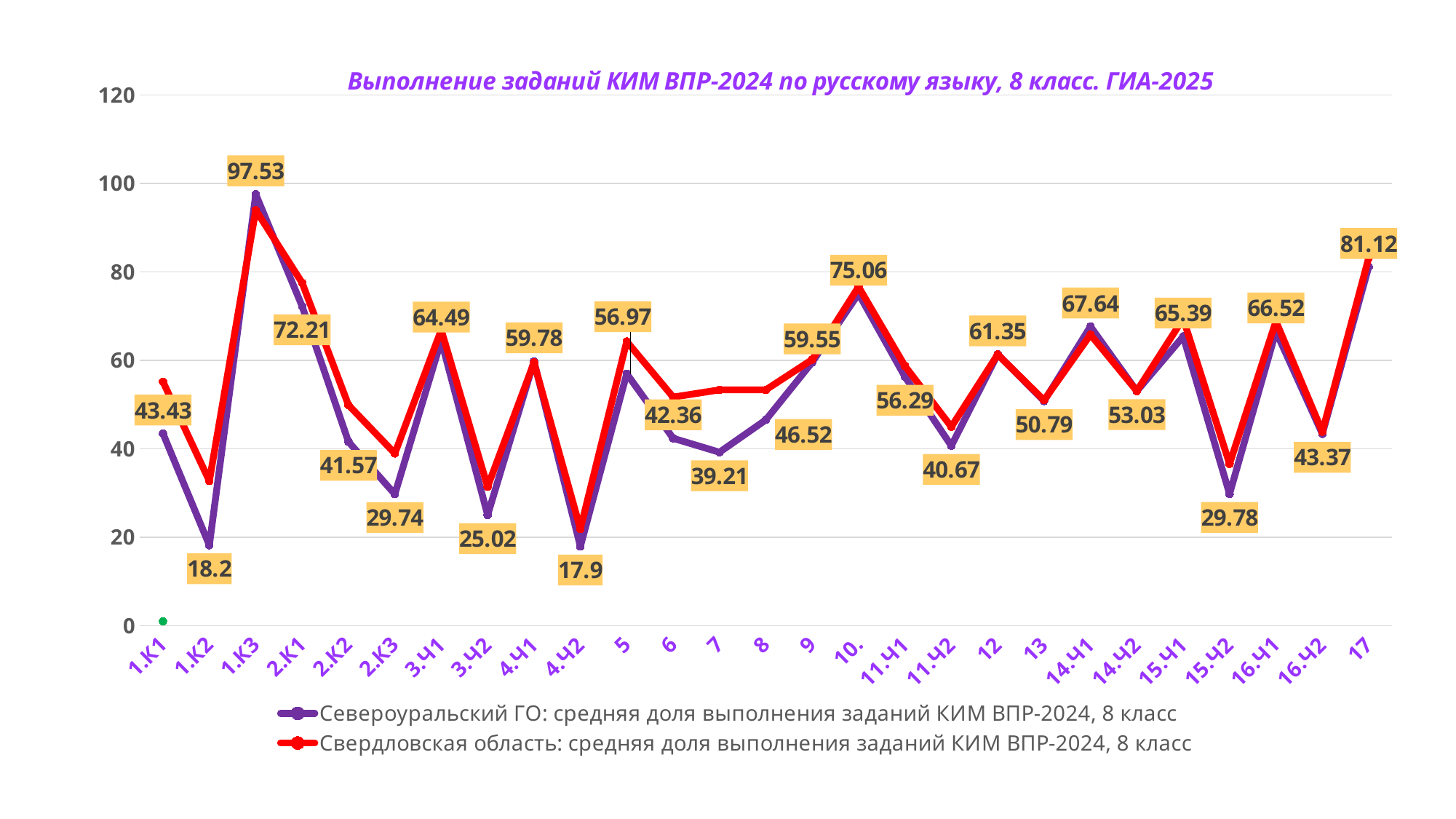
What is the value for Североуральский ГО at 4.Ч2? 17.9 Is the Свердловская область value at 1.К2 greater or less than 40? less How many categories are plotted along the x axis? 27 What colour is the line for Свердловская область? red What is the value for Североуральский ГО at 17? 81.12 How many series does the legend list? 2 At which category does the Североуральский ГО series reach its lowest value? 4.Ч2 At 1.К1, which series has the higher value: Североуральский ГО or Свердловская область? Свердловская область What type of chart is shown on the slide? line chart What is the difference between the Североуральский ГО values at 1.К3 and 1.К2? 79.33 What is the value for Североуральский ГО at 1.К3? 97.53 At which category does the Североуральский ГО series reach its highest value? 1.К3